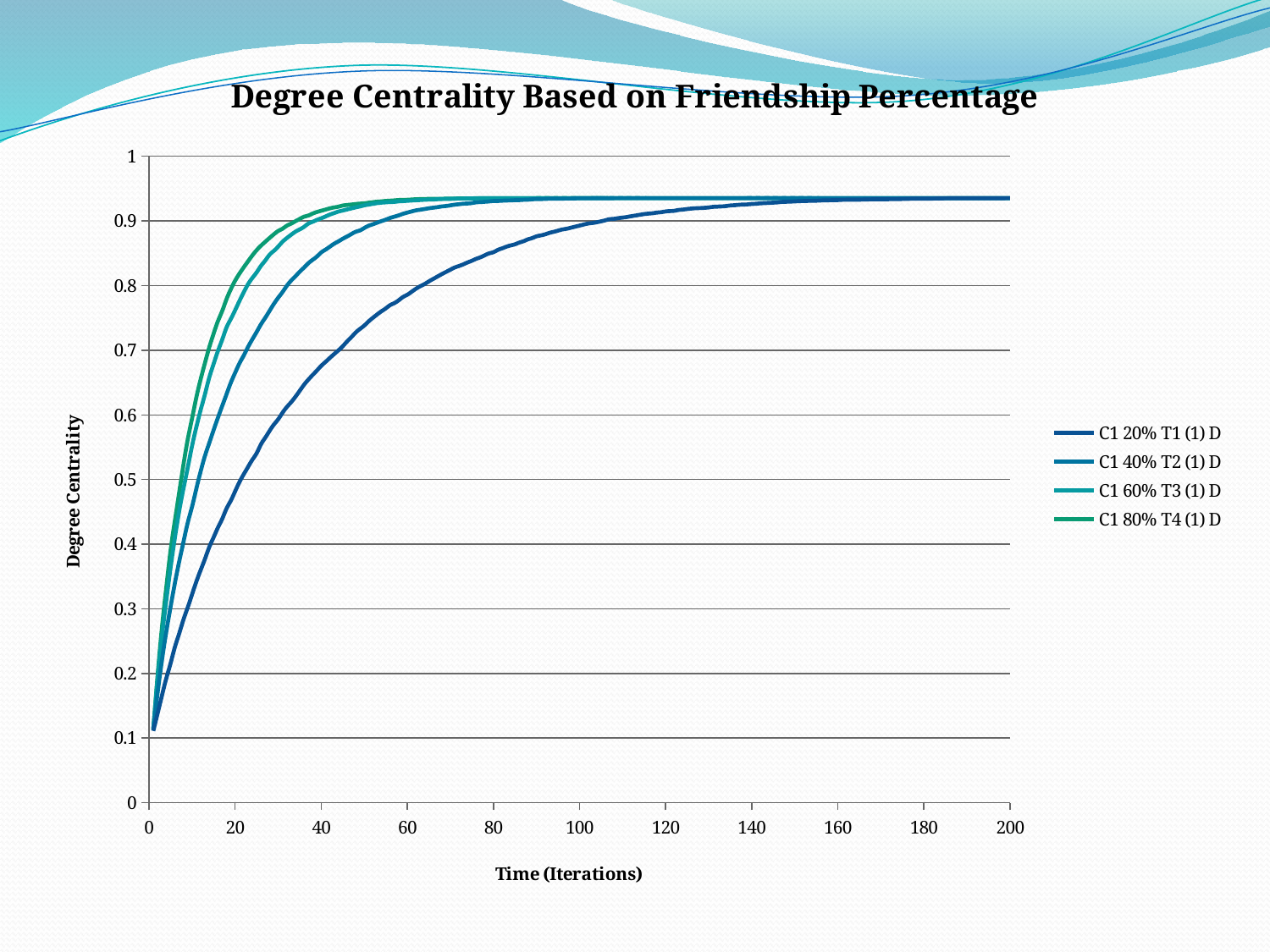
At 40 iterations, is the value for C1 20% T1 (1) D greater or less than 0.7? less At 40 iterations, which series has the higher value, C1 20% T1 (1) D or C1 80% T4 (1) D? C1 80% T4 (1) D Do the values of the C1 20% T1 (1) D series rise or fall as time increases? rise What is the label of the x axis? Time (Iterations) At 20 iterations, is the value for C1 60% T3 (1) D greater or less than 0.7? greater What kind of chart is shown on the slide? line chart Which series rises most slowly toward its plateau? C1 20% T1 (1) D How many series does the legend list? 4 What is the title of the chart? Degree Centrality Based on Friendship Percentage At 20 iterations, which series has the higher value, C1 40% T2 (1) D or C1 20% T1 (1) D? C1 40% T2 (1) D At 80 iterations, is the value for C1 20% T1 (1) D greater or less than 0.8? greater